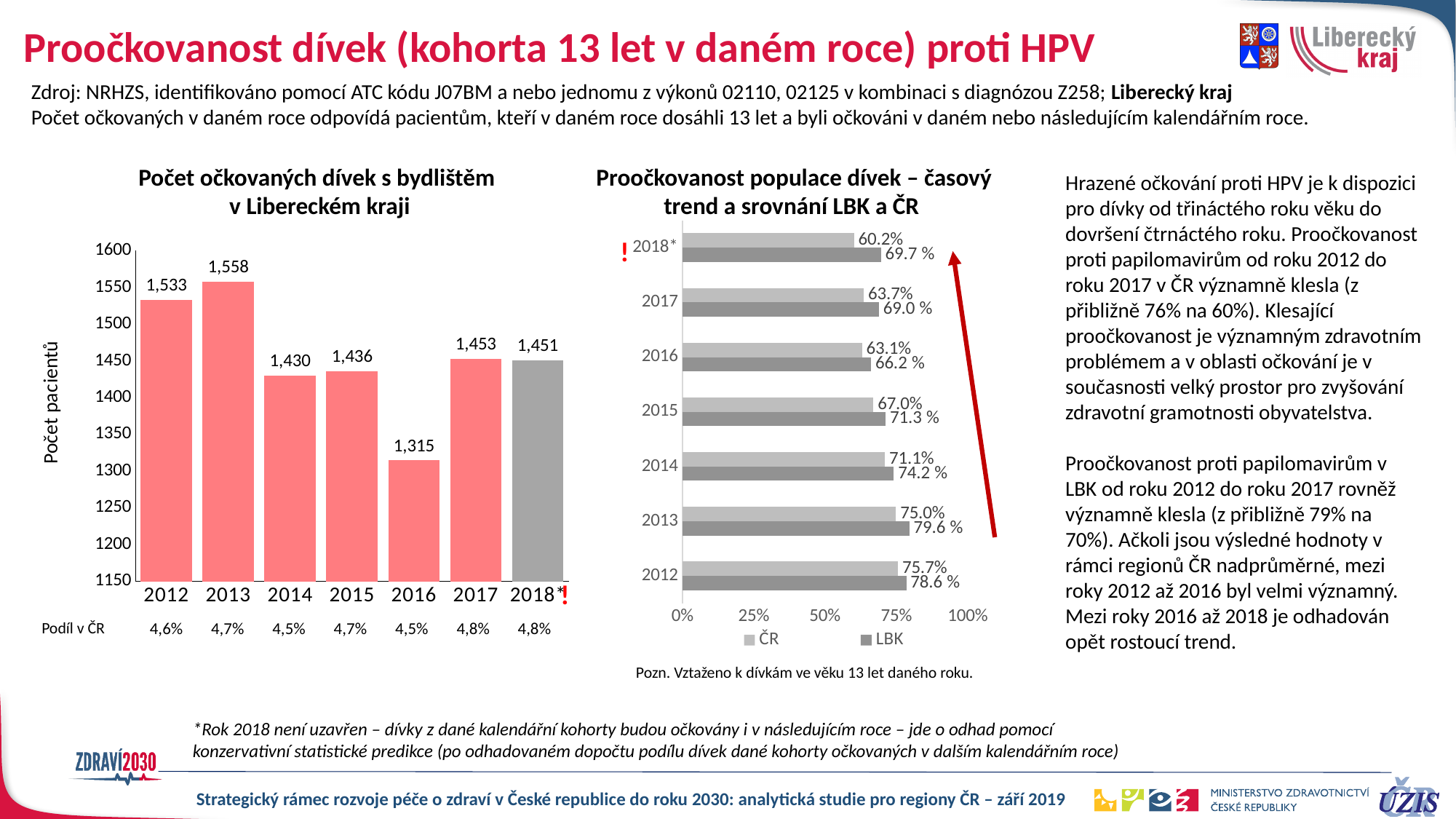
In the chart 'Počet očkovaných dívek s bydlištěm v Libereckém kraji', what is the difference between the values for 2013 and 2016? 243 In the chart 'Počet očkovaných dívek s bydlištěm v Libereckém kraji', what is the value for 2013? 1,558 In the chart 'Proočkovanost populace dívek – časový trend a srovnání LBK a ČR', is the ČR value for 2012 larger or smaller than the LBK value for 2012? Smaller In the chart 'Počet očkovaných dívek s bydlištěm v Libereckém kraji', which year has the lowest value? 2016 In the chart 'Proočkovanost populace dívek – časový trend a srovnání LBK a ČR', how many series does the legend list? 2 In the chart 'Počet očkovaných dívek s bydlištěm v Libereckém kraji', which year has the highest value? 2013 In the chart 'Proočkovanost populace dívek – časový trend a srovnání LBK a ČR', what is the difference between the LBK and ČR values for 2017? 5.3 % What kind of chart is 'Počet očkovaných dívek s bydlištěm v Libereckém kraji'? Bar chart In the chart 'Proočkovanost populace dívek – časový trend a srovnání LBK a ČR', what is the ČR value for 2018*? 60.2% In the chart 'Počet očkovaných dívek s bydlištěm v Libereckém kraji', how many years are shown on the x axis? 7 In the chart 'Proočkovanost populace dívek – časový trend a srovnání LBK a ČR', which year has the highest LBK value? 2013 In the chart 'Proočkovanost populace dívek – časový trend a srovnání LBK a ČR', what is the LBK value for 2015? 71.3 %